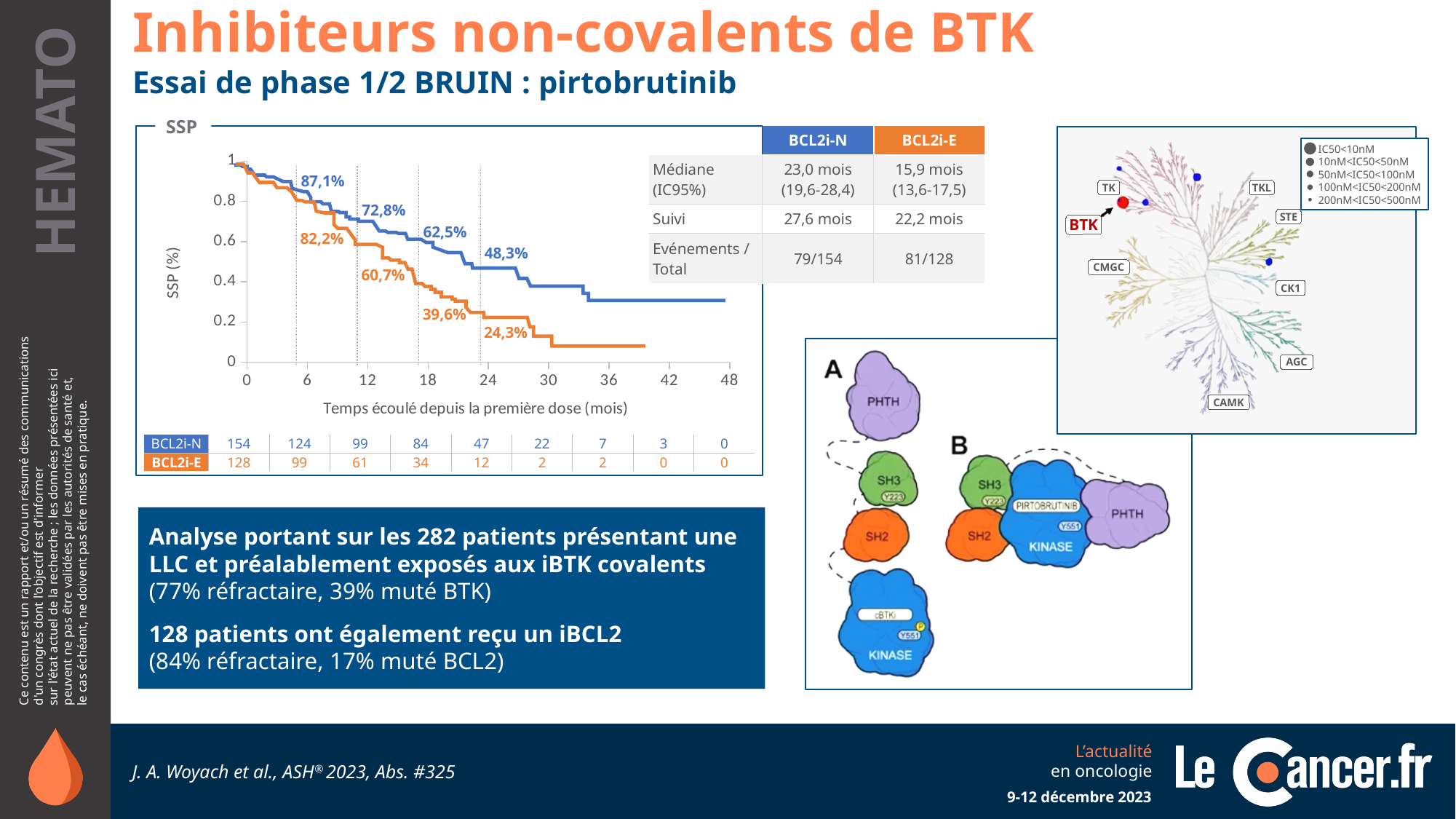
On the SSP chart, do the curves rise or fall as time since first dose increases? Fall On the SSP chart, what is the first labelled value on the BCL2i-N curve? 87,1% On the SSP chart, what is the third labelled value on the BCL2i-N curve? 62,5% On the SSP chart, what is the last labelled value on the BCL2i-E curve? 24,3% How many series are plotted on the SSP chart? 2 On the SSP chart, what is the difference in percentage points between the last labelled values of BCL2i-N (48,3%) and BCL2i-E (24,3%)? 24,0 points What is the x-axis title of the SSP chart? Temps écoulé depuis la première dose (mois) On the SSP chart, which curve has the higher last labelled value, BCL2i-N or BCL2i-E? BCL2i-N In the number-at-risk table under the SSP chart, how many BCL2i-E patients are at risk at time 0? 128 On the SSP chart, what is the second labelled value on the BCL2i-E curve? 60,7% On the SSP chart, what is the difference in percentage points between the first labelled values of BCL2i-N (87,1%) and BCL2i-E (82,2%)? 4,9 points What type of chart is the SSP chart on the left of the slide? Line chart (Kaplan-Meier survival curve)